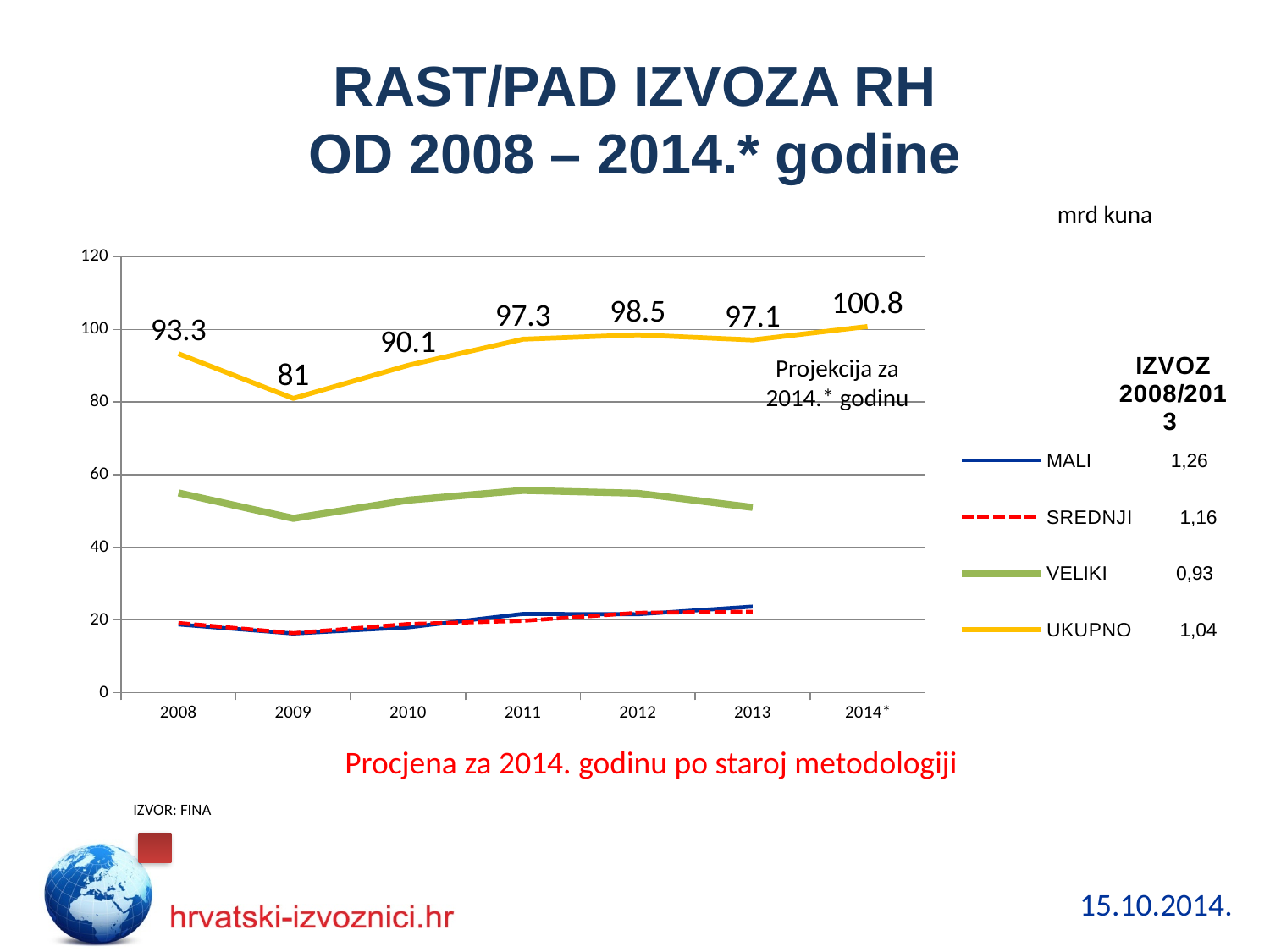
In which year is the UKUPNO series at its lowest? 2009 Is the value for VELIKI in 2009 greater or less than 60? less How many years are shown on the x axis of the chart? 7 In which year is the UKUPNO series at its highest? 2014* What is the projected value of the UKUPNO series for 2014*? 100.8 What is the value of the UKUPNO series in 2008? 93.3 Is the value for VELIKI in 2011 greater or less than 40? greater How many series does the chart legend list? 4 What is the value of the UKUPNO series in 2009? 81 Which year has the larger UKUPNO value, 2011 or 2012? 2012 By how much does the UKUPNO value for 2014* exceed the value for 2013? 3.7 What type of chart is shown on the slide? Line chart